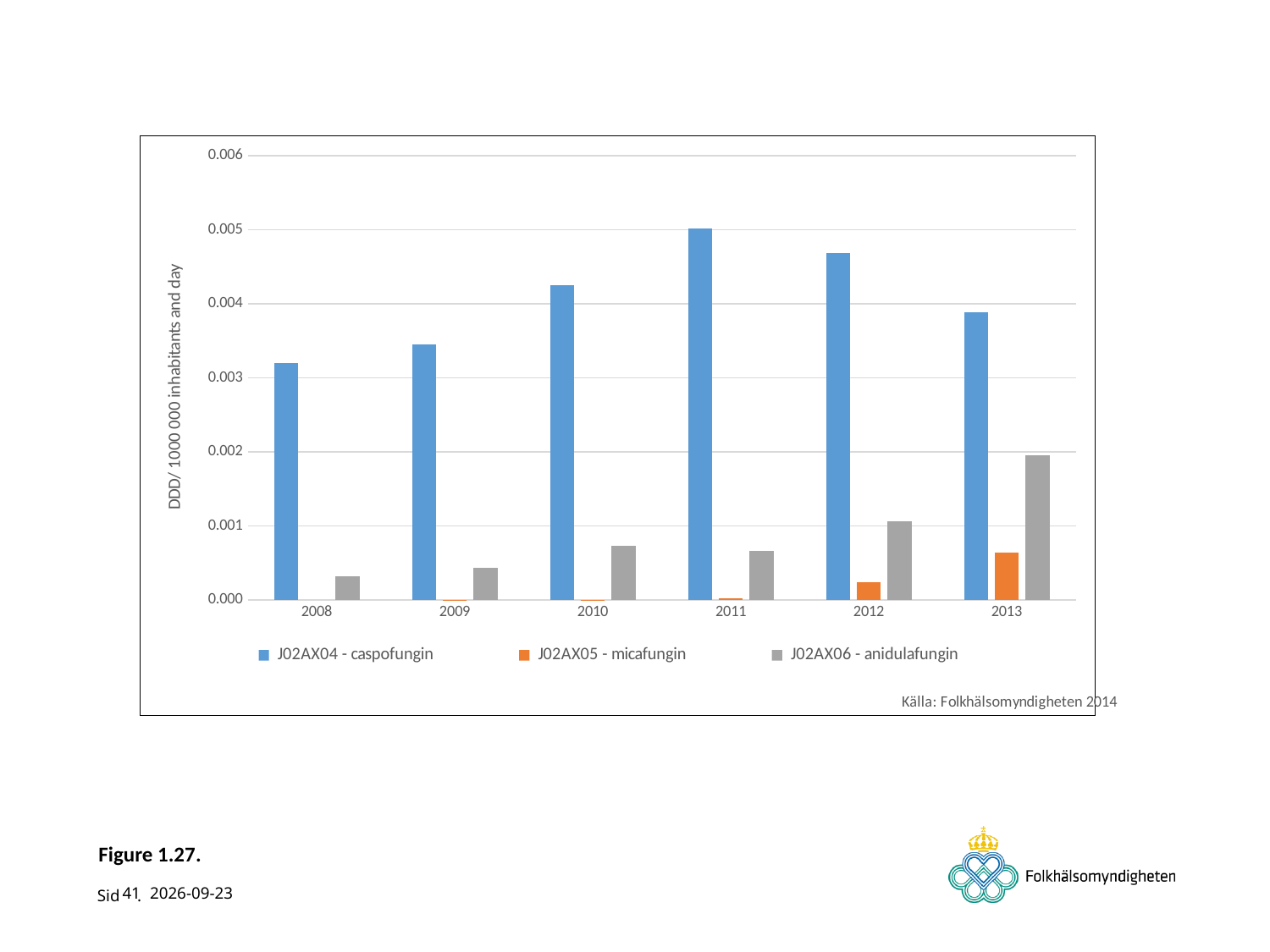
Which is larger in 2013: the value for J02AX05 - micafungin or the value for J02AX06 - anidulafungin? J02AX06 - anidulafungin Is the value for J02AX06 - anidulafungin in 2013 greater or less than 0.001? greater What kind of chart is shown on the slide? bar chart What is the label on the y axis? DDD/ 1000 000 inhabitants and day In which year is the value for J02AX06 - anidulafungin highest? 2013 How many years are shown on the x axis? 6 How many series does the legend list? 3 In which year is the value for J02AX06 - anidulafungin lowest? 2008 Does the value for J02AX04 - caspofungin rise or fall from 2008 to 2011? rise In which year is the value for J02AX04 - caspofungin highest? 2011 Is the value for J02AX04 - caspofungin in 2008 greater or less than 0.004? less Is the value for J02AX04 - caspofungin in 2012 greater or less than 0.004? greater